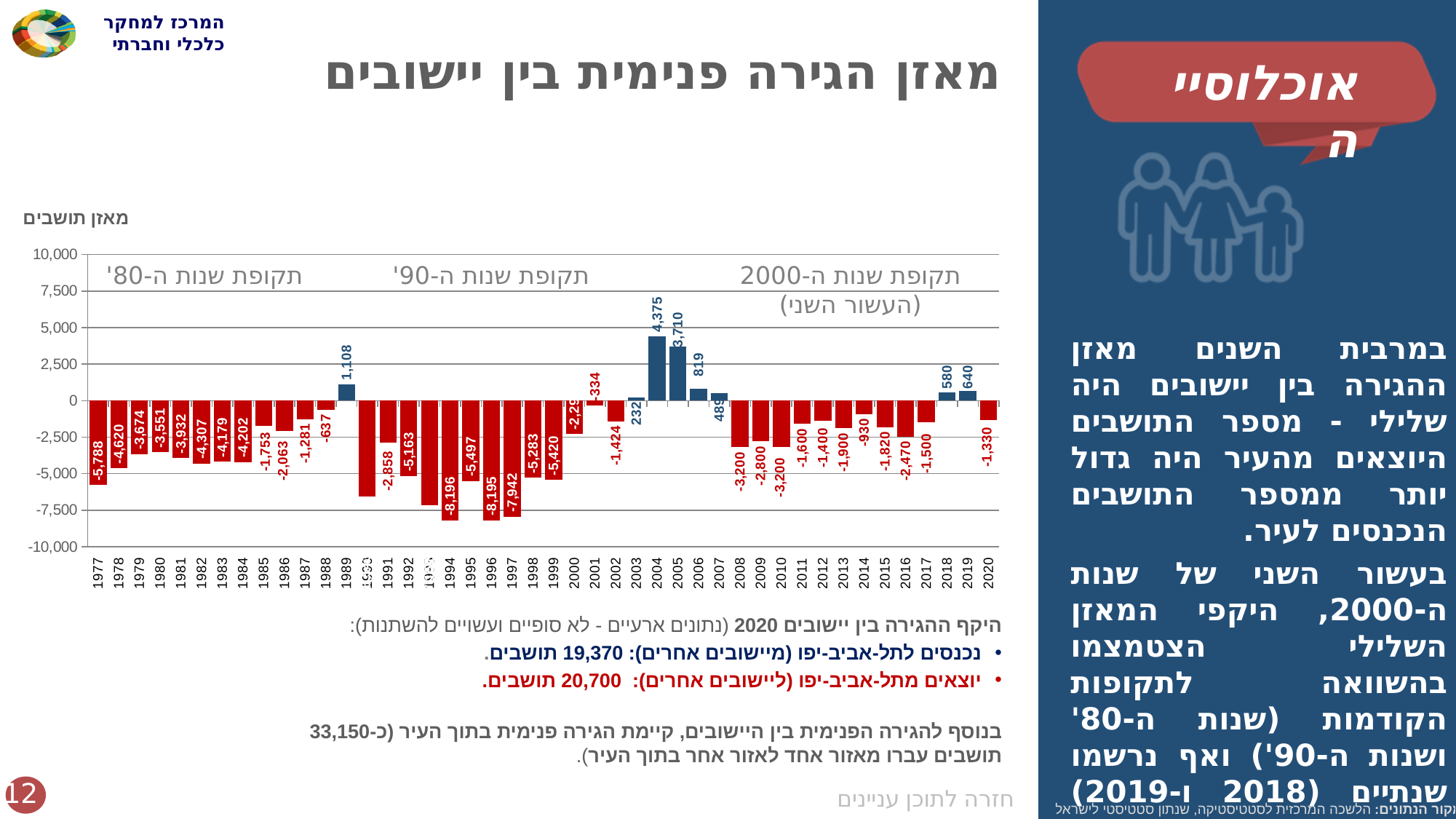
What is the title of the chart? מאזן הגירה פנימית בין יישובים Which year has the highest value in the chart? 2004 What is the value for 2020 in the chart? -1,330 What is the difference between the values for 2019 and 2018? 60 What kind of chart is shown on the slide? bar chart Which year has the larger value, 2004 or 2005? 2004 Is the value for 1990 greater or less than -5,000? less What is the value for 1989 in the chart? 1,108 What is the difference between the values for 2008 and 2009? 400 What is the value for 1977 in the chart? -5,788 What is the value for 2004 in the chart? 4,375 How many years are plotted in the chart? 44